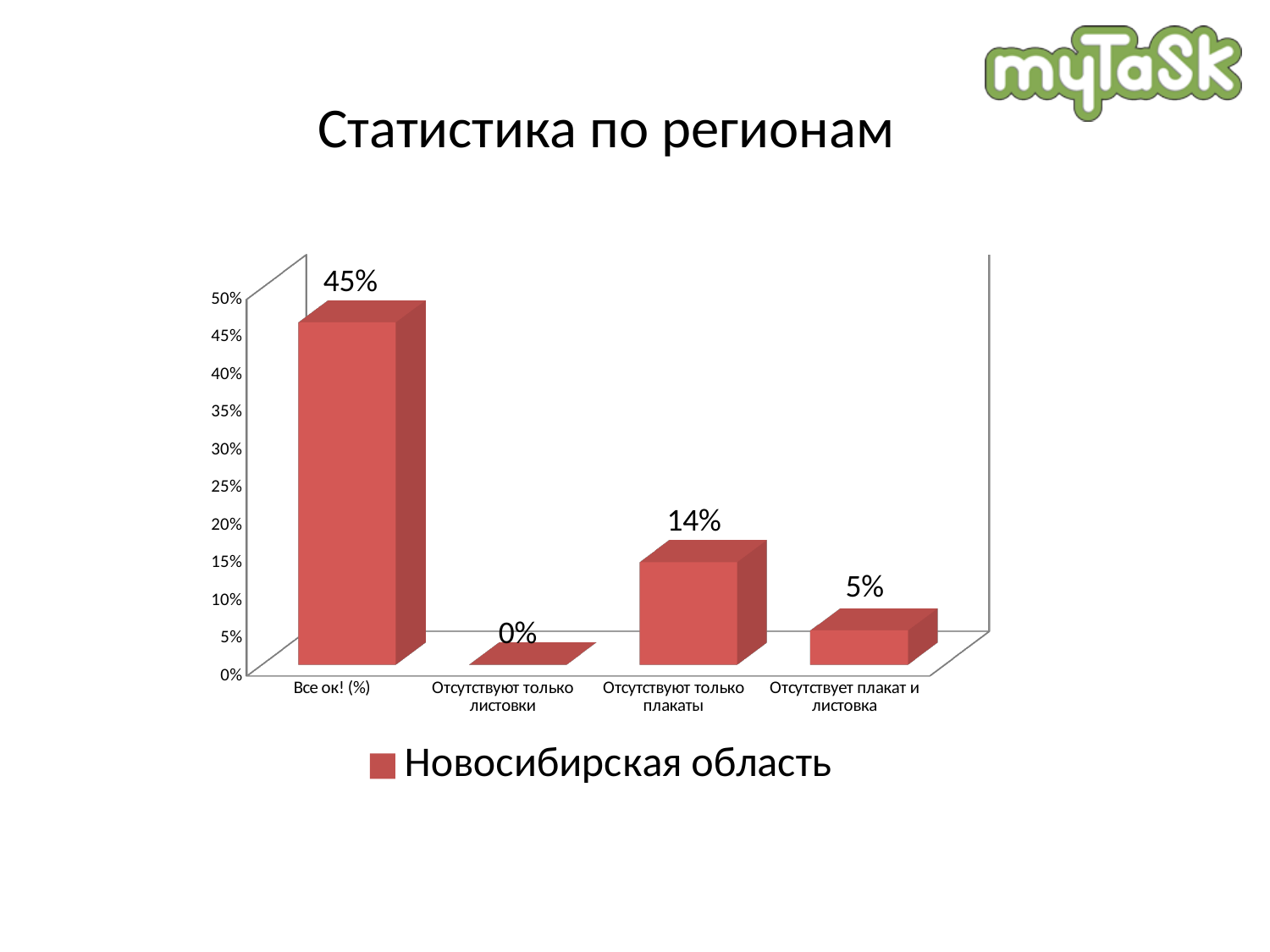
What is the difference between the values for "Все ок! (%)" and "Отсутствуют только плакаты"? 31% What is the value for "Все ок! (%)"? 45% How many series does the legend list? 1 What is the value for "Отсутствуют только листовки"? 0% What is the value for "Отсутствует плакат и листовка"? 5% How many categories are shown on the x axis? 4 What is the value for "Отсутствуют только плакаты"? 14% What kind of chart is shown on the slide? Bar chart What series name is shown in the legend? Новосибирская область Which category has the highest value? Все ок! (%) Which category has the lowest value? Отсутствуют только листовки Which is larger: the value for "Отсутствуют только плакаты" or for "Отсутствует плакат и листовка"? Отсутствуют только плакаты